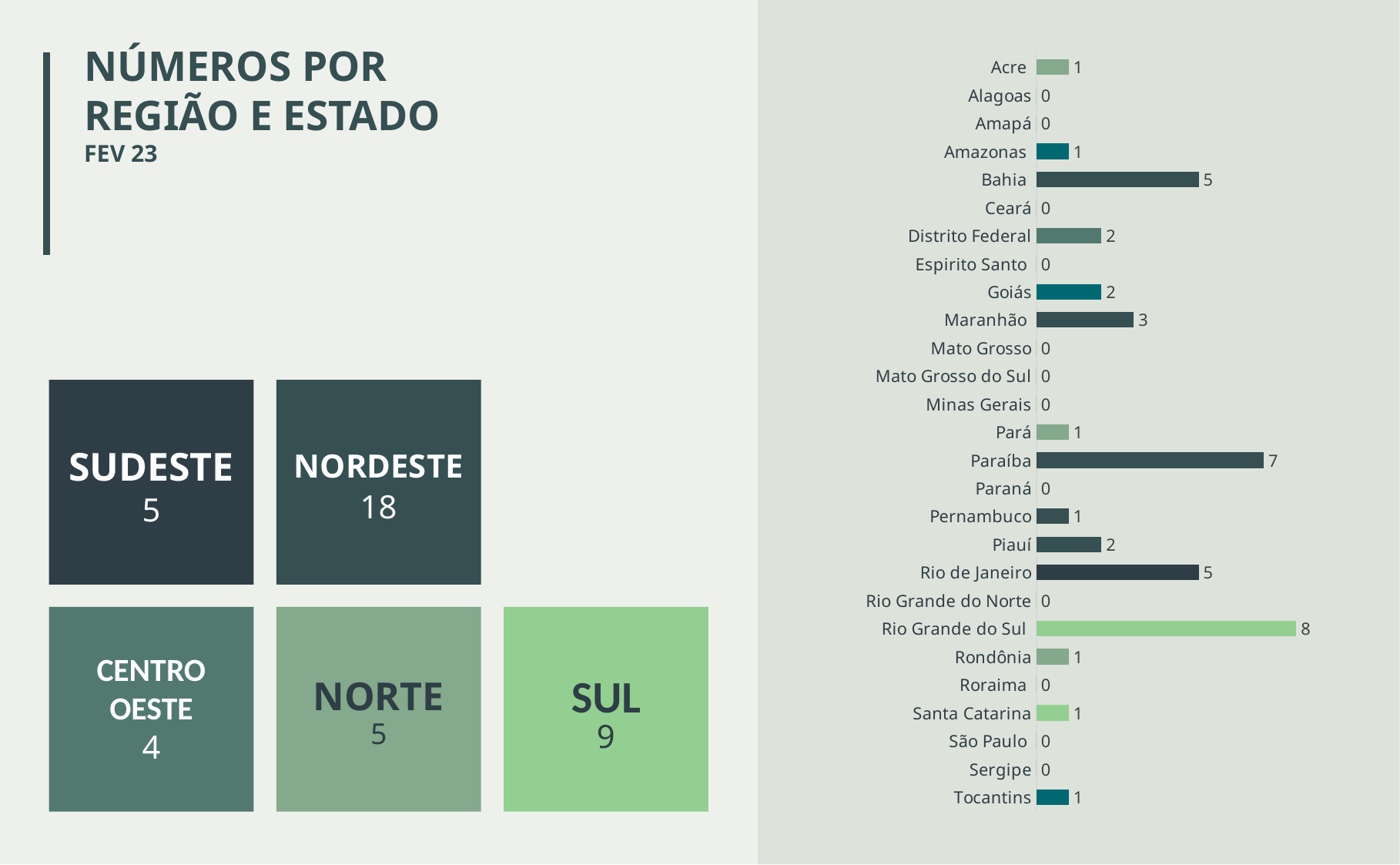
What is the value for Paraíba in the bar chart? 7 Which has a larger value, Goiás or Maranhão? Maranhão What is the difference between the values for Rio Grande do Sul and Paraíba? 1 What type of chart is shown on the slide? bar chart How many states are listed in the bar chart? 27 How many states in the bar chart have a value of 0? 12 Which has a larger value, Rio de Janeiro or Pernambuco? Rio de Janeiro What is the difference between the values for Bahia and Piauí? 3 What is the value for Bahia in the bar chart? 5 Which state has the highest value in the bar chart? Rio Grande do Sul What is the value for Maranhão in the bar chart? 3 What is the value for Distrito Federal in the bar chart? 2